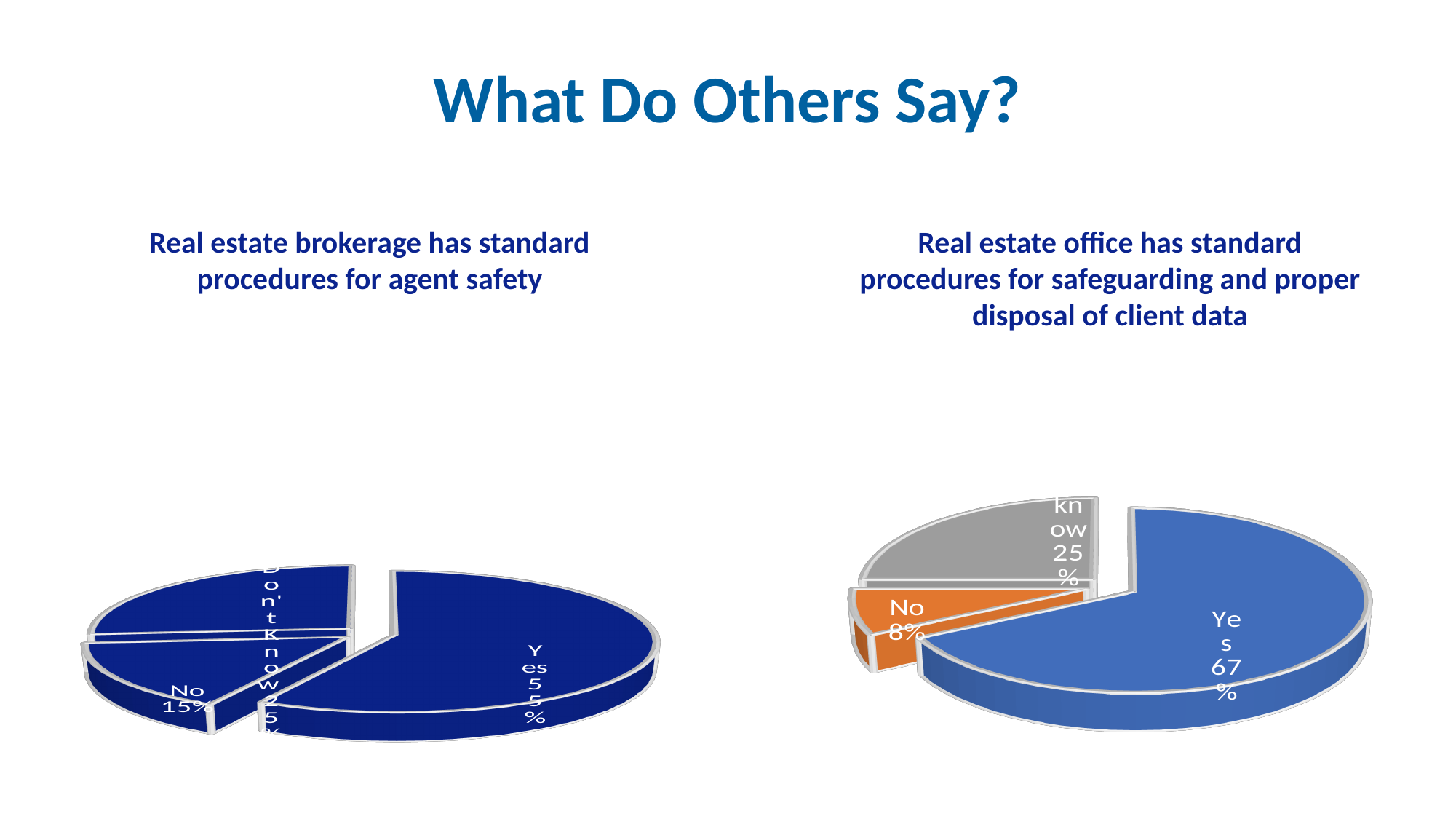
In the pie chart titled "Real estate office has standard procedures for safeguarding and proper disposal of client data", what percentage answered Yes? 67% In the pie chart titled "Real estate brokerage has standard procedures for agent safety", what percentage answered No? 15% In the right-hand pie chart about safeguarding client data, which response has the smallest slice? No Is the Yes percentage larger in the left-hand chart (agent safety) or the right-hand chart (safeguarding client data)? Right-hand chart (safeguarding client data) In the pie chart titled "Real estate brokerage has standard procedures for agent safety", what percentage answered Yes? 55% In the right-hand pie chart about safeguarding client data, which response has the largest slice? Yes In the left-hand pie chart about agent safety, which response has the largest slice? Yes How many slices does the right-hand pie chart about safeguarding client data have? 3 In the pie chart titled "Real estate office has standard procedures for safeguarding and proper disposal of client data", what percentage answered No? 8% In the pie chart titled "Real estate office has standard procedures for safeguarding and proper disposal of client data", what percentage answered Don't know? 25% What type of chart is used on this slide? Pie chart In the right-hand pie chart about safeguarding client data, what is the difference between the Yes and No percentages? 59%